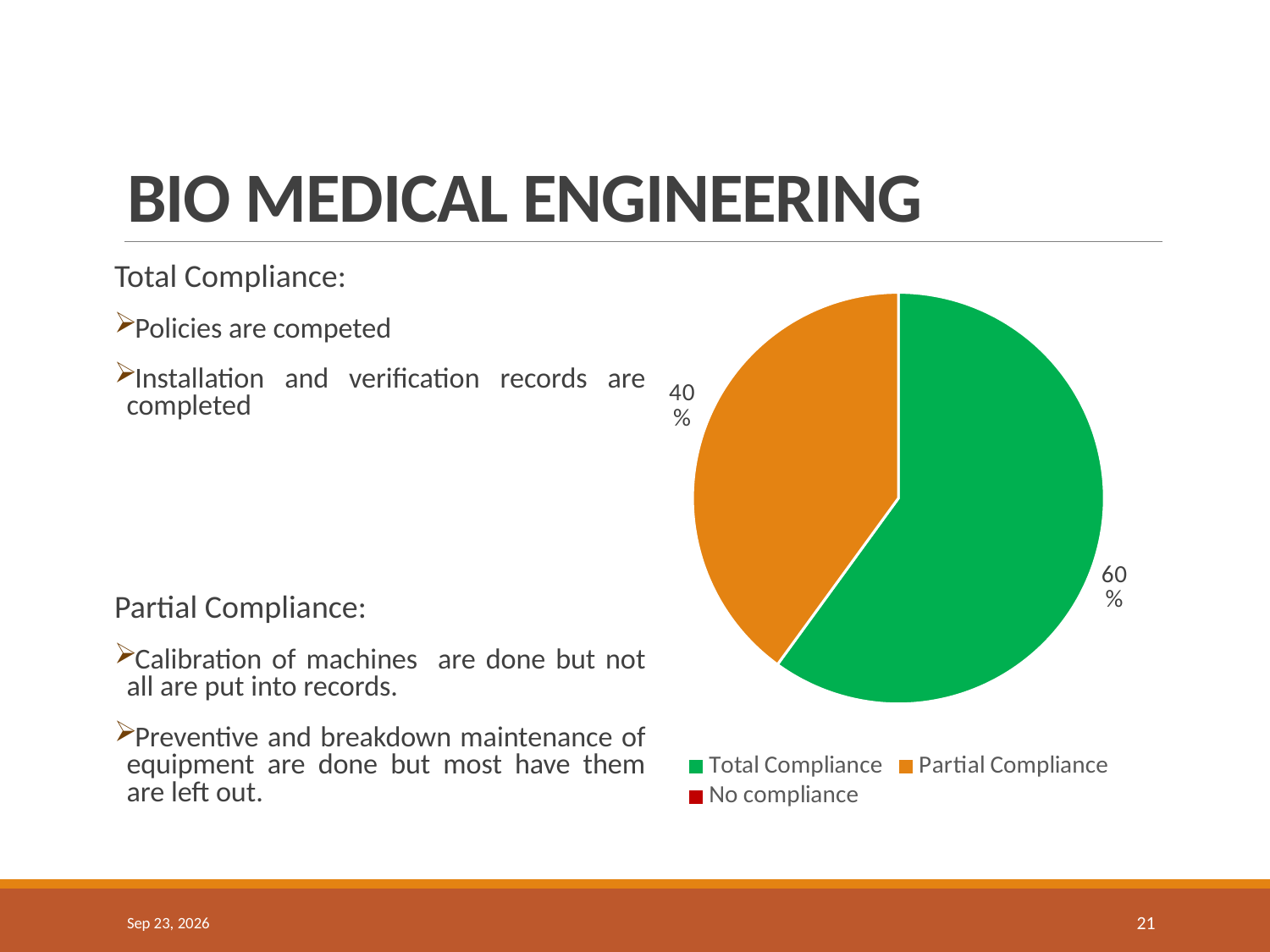
What is the difference between the Total Compliance and Partial Compliance shares? 20% Which legend entry has no visible slice in the pie? No compliance How many entries does the legend list? 3 What share of the pie does Partial Compliance have? 40% What share of the pie does Total Compliance have? 60% What colour is the Total Compliance slice? green Which is larger, Total Compliance or Partial Compliance? Total Compliance What kind of chart is shown on the slide? pie chart Is the share for Partial Compliance greater or less than 50%? less How many slices are visible in the pie? 2 Which category has the largest slice of the pie? Total Compliance